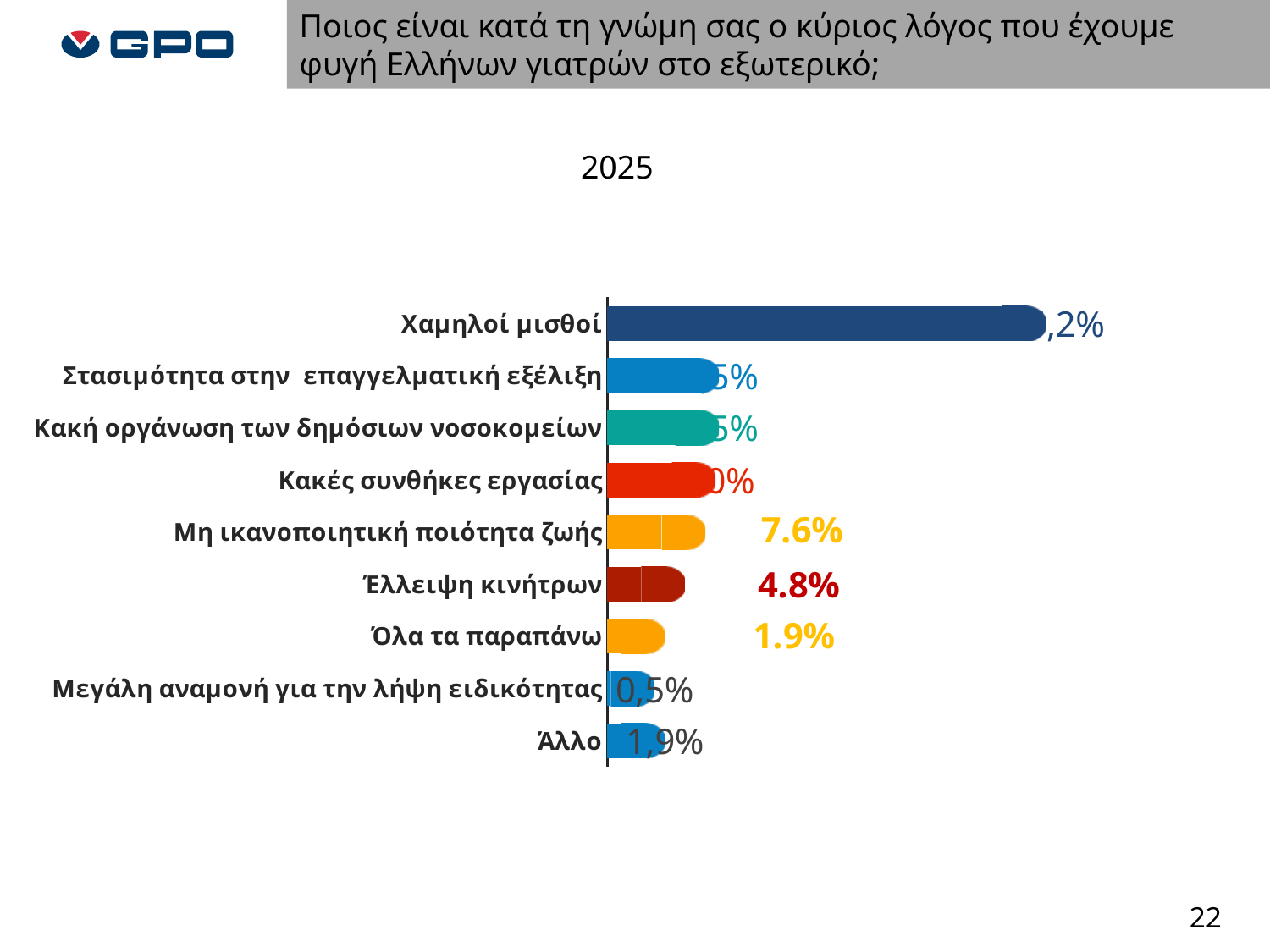
What year is shown as the chart's title? 2025 What is the value for Μη ικανοποιητική ποιότητα ζωής? 7.6% What is the value for Έλλειψη κινήτρων? 4.8% What is the value for Όλα τα παραπάνω? 1.9% How many categories are plotted in the chart? 9 Which category has the lowest value? Μεγάλη αναμονή για την λήψη ειδικότητας What is the value for Μεγάλη αναμονή για την λήψη ειδικότητας? 0,5% Which is larger, the value for Μη ικανοποιητική ποιότητα ζωής or the value for Έλλειψη κινήτρων? Μη ικανοποιητική ποιότητα ζωής What is the difference between the values for Μη ικανοποιητική ποιότητα ζωής and Έλλειψη κινήτρων? 2.8% What is the value for Άλλο? 1,9% What kind of chart is shown on the slide? bar chart Which category has the highest value? Χαμηλοί μισθοί